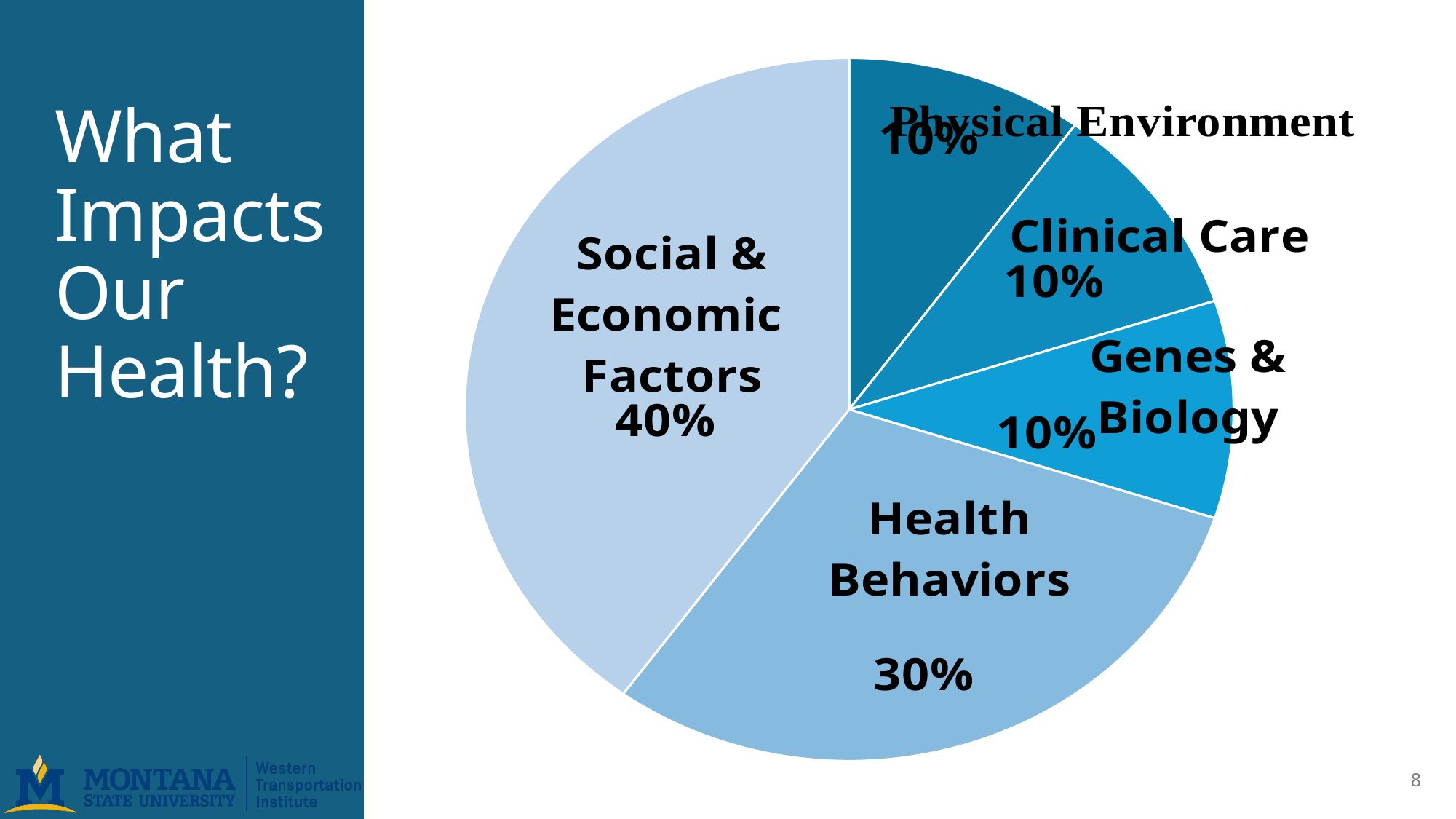
Which slice of the pie is the largest? Social & Economic Factors What kind of chart is shown on the slide? Pie chart Which is larger, the Health Behaviors slice or the Clinical Care slice? Health Behaviors What share of the pie is Genes & Biology? 10% What share of the pie is Health Behaviors? 30% What share of the pie is Physical Environment? 10% What is the combined share of Social & Economic Factors and Health Behaviors? 70% What is the difference between the Social & Economic Factors share and the Health Behaviors share? 10% What is the title text shown on the left of the slide? What Impacts Our Health? How many slices does the pie chart have? 5